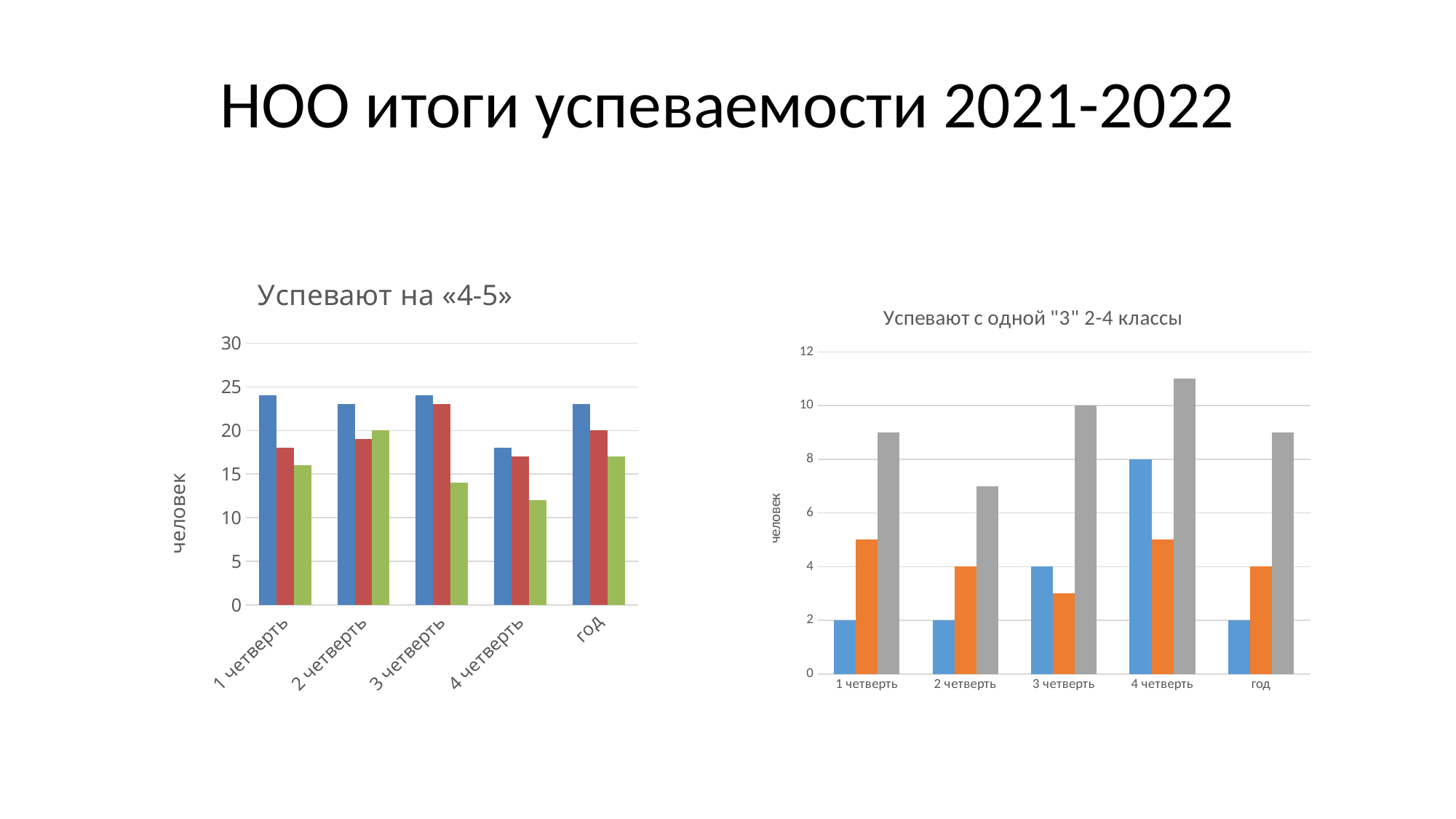
In the right chart «Успевают с одной "3" 2-4 классы», what is the value of the grey bar for 3 четверть? 10 In the left chart «Успевают на «4-5»», for 4 четверть, which is larger: the blue bar or the green bar? the blue bar In the left chart «Успевают на «4-5»», is the value of the green bar for 4 четверть greater or less than 15? less What is the y-axis label of the left chart «Успевают на «4-5»»? человек In the right chart «Успевают с одной "3" 2-4 классы», what is the value of the blue bar for 4 четверть? 8 In the left chart «Успевают на «4-5»», for which category is the green bar lowest? 4 четверть In the right chart «Успевают с одной "3" 2-4 классы», what is the value of the orange bar for год? 4 In the right chart «Успевают с одной "3" 2-4 классы», what is the value of the blue bar for 1 четверть? 2 What kind of chart is the left chart titled «Успевают на «4-5»»? bar chart In the right chart «Успевают с одной "3" 2-4 классы», for which category is the grey bar highest? 4 четверть How many categories are shown on the x axis of the right chart «Успевают с одной "3" 2-4 классы»? 5 In the left chart «Успевают на «4-5»», is the value of the blue bar for 1 четверть greater or less than 20? greater